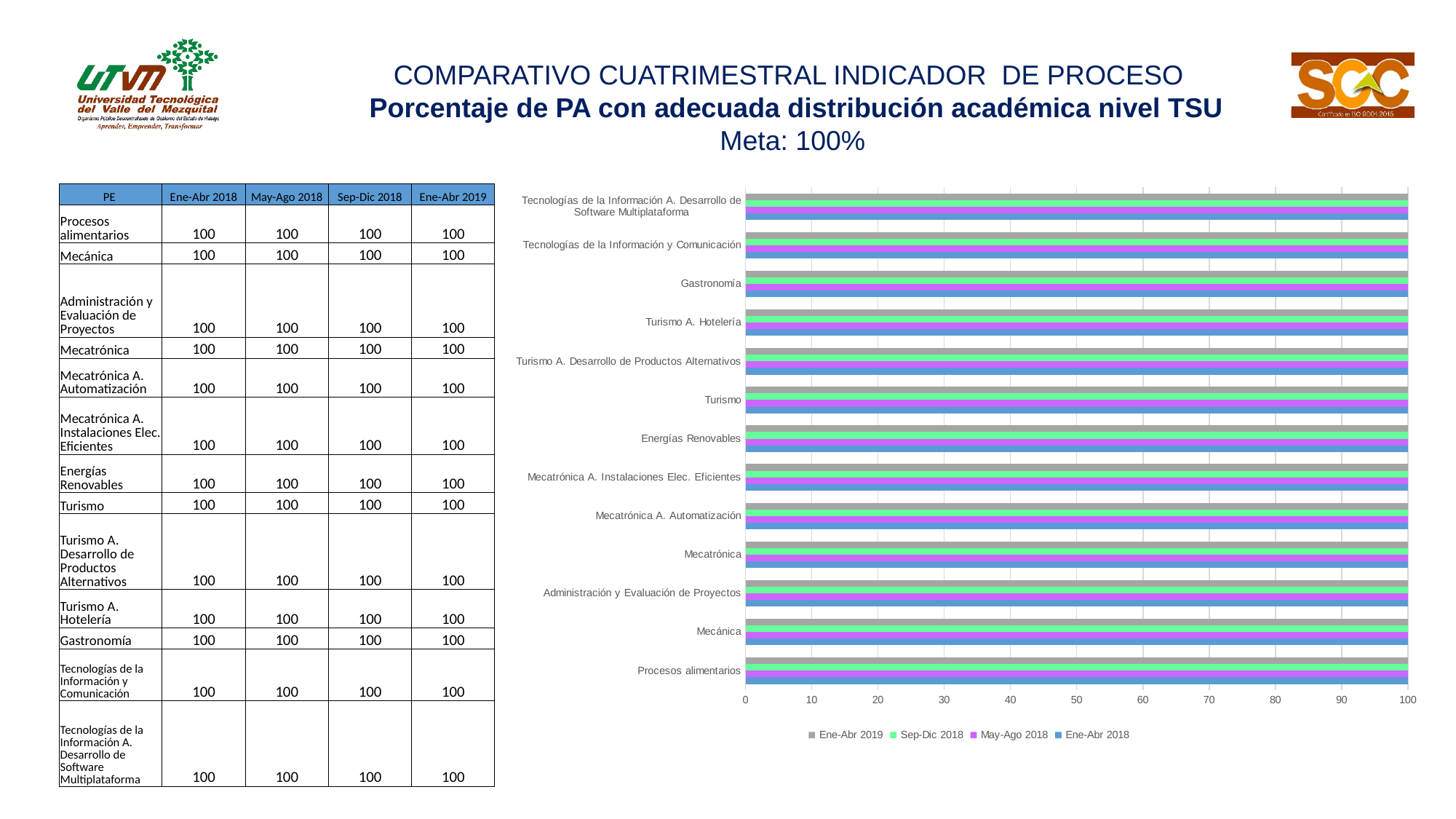
How many categories (programs) are plotted on the chart? 13 Which series is listed first in the chart legend? Ene-Abr 2019 What kind of chart is shown on the slide? bar chart What is the maximum value shown on the chart's horizontal axis? 100 What is the value for Gastronomía in the Sep-Dic 2018 series? 100 What is the value for Tecnologías de la Información y Comunicación in the Sep-Dic 2018 series? 100 What is the value for Turismo in the May-Ago 2018 series? 100 What is the value for Energías Renovables in the Ene-Abr 2018 series? 100 What is the difference between the Ene-Abr 2018 and Ene-Abr 2019 values for Mecatrónica? 0 How many series does the chart legend list? 4 What is the value for Mecánica in the Ene-Abr 2019 series? 100 Is the value for Procesos alimentarios in Ene-Abr 2019 greater or less than 50? greater